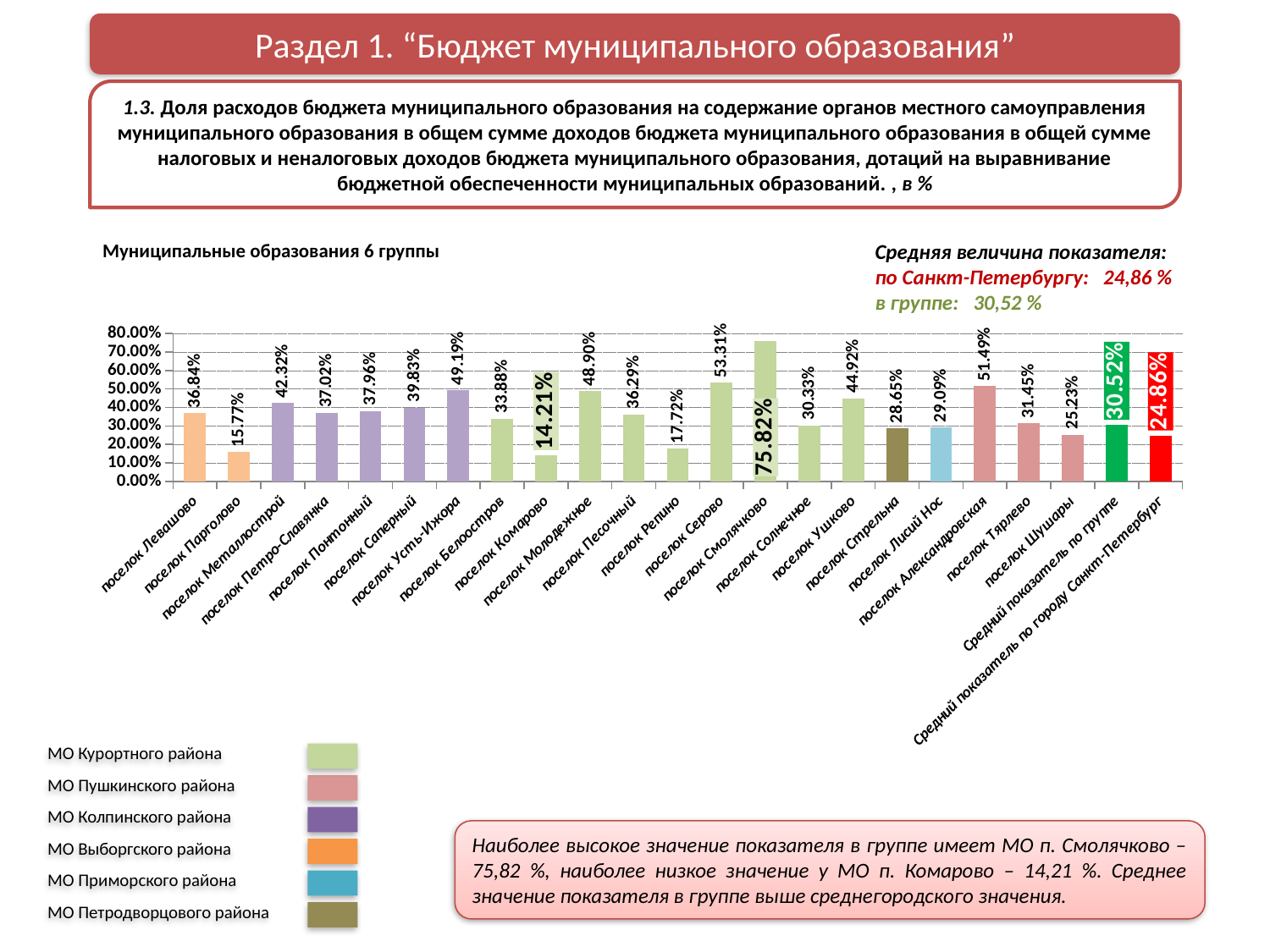
How many district groups are listed in the colour legend below the chart? 6 How many bars are plotted on the chart? 23 What is the value for поселок Усть-Ижора? 49.19% What is the value for поселок Смолячково? 75.82% What kind of chart is shown on the slide? bar chart Is the value for поселок Александровская greater or less than 50.00%? greater What is the value shown for Средний показатель по группе? 30.52% Which category has the highest value on the chart? поселок Смолячково What is the difference between the group average (Средний показатель по группе) and the city average (Средний показатель по городу Санкт-Петербург)? 5.66% What is the difference between the values for поселок Серово and поселок Репино? 35.59% Which is larger, the value for поселок Металлострой or the value for поселок Ушково? поселок Ушково Which category has the lowest value on the chart? поселок Комарово